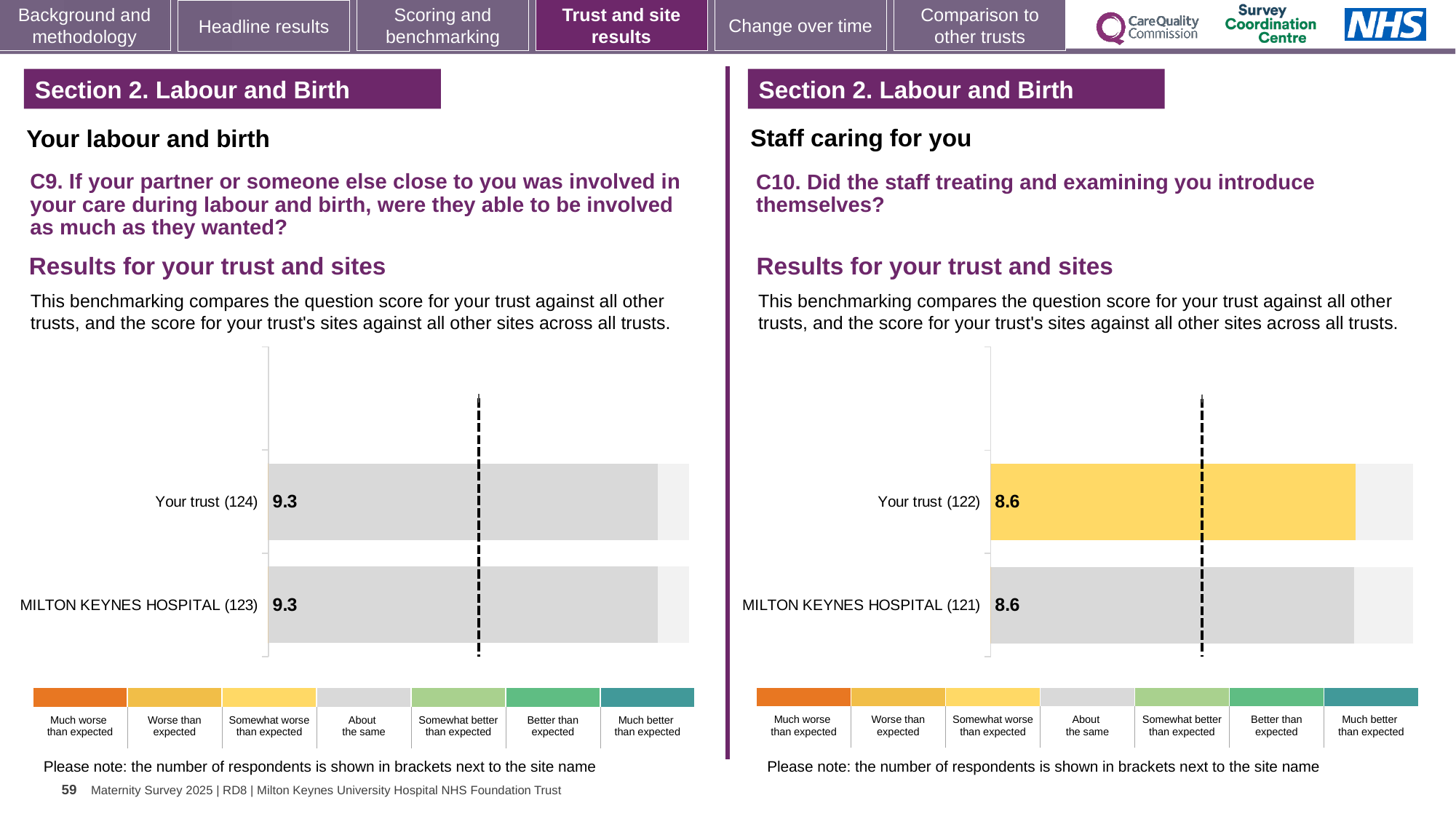
In the right chart (C10), how many respondents are shown in brackets for MILTON KEYNES HOSPITAL? 121 In the right chart (C10), what is the score for Your trust (122)? 8.6 In the left chart (C9), what is the score for Your trust (124)? 9.3 In the right chart (C10), what colour is the bar for Your trust (122)? Yellow In the right chart (C10), what is the difference between the score for Your trust and the score for MILTON KEYNES HOSPITAL? 0.0 What kind of chart is used in the left chart (C9)? Bar chart How many bars are plotted in the left chart (C9)? 2 How many bars are plotted in the right chart (C10)? 2 In the right chart (C10), what is the score for MILTON KEYNES HOSPITAL (121)? 8.6 Is the score for Your trust in the left chart (C9) larger or smaller than the score for Your trust in the right chart (C10)? Larger In the left chart (C9), what is the difference between the score for Your trust and the score for MILTON KEYNES HOSPITAL? 0.0 In the left chart (C9), what is the score for MILTON KEYNES HOSPITAL (123)? 9.3